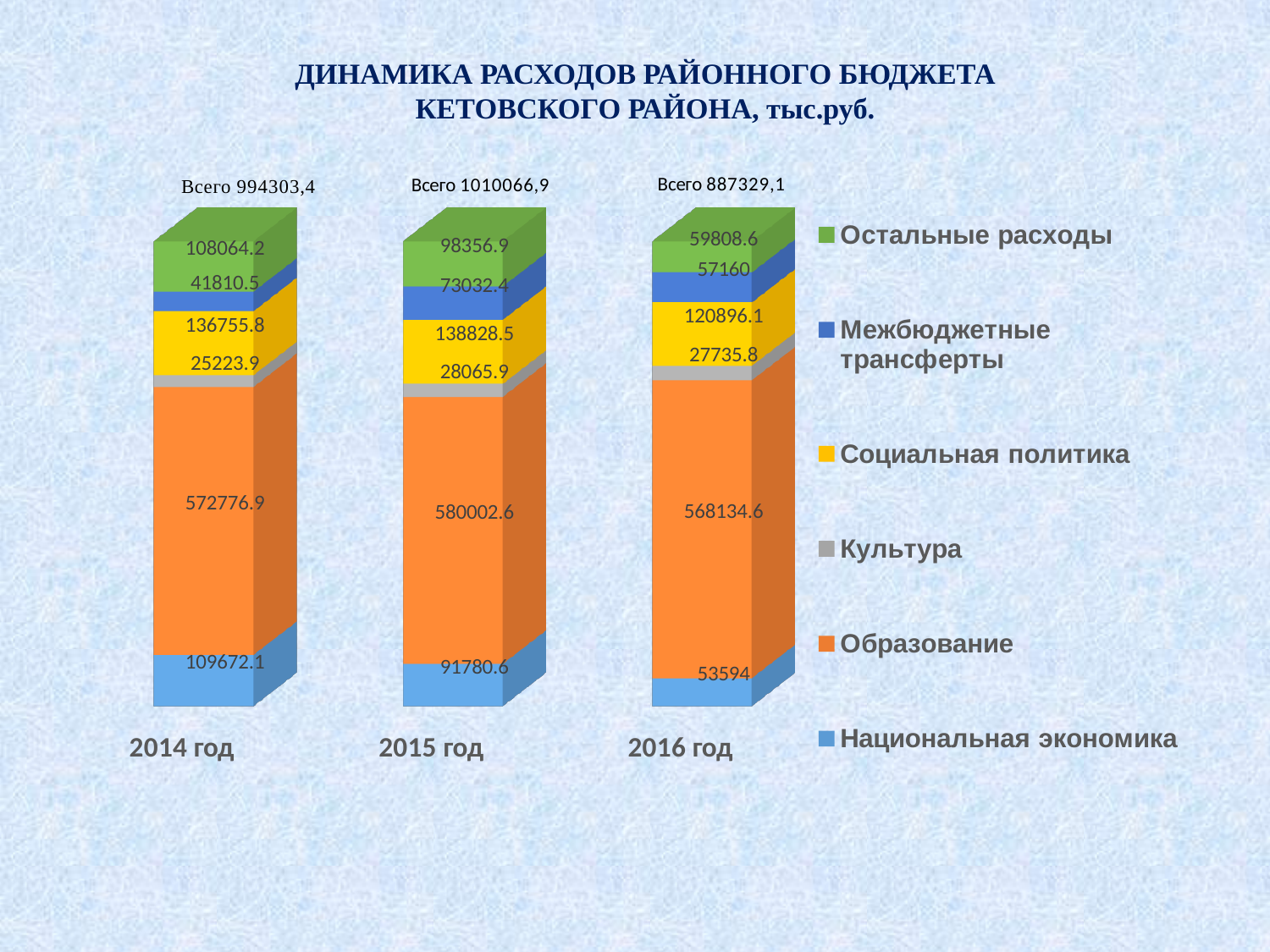
What is the difference between the Национальная экономика values for 2014 год and 2015 год? 17891.5 Which year has the lowest value for Национальная экономика? 2016 год How many series does the legend list? 6 What kind of chart is shown on the slide? Stacked bar chart How many years (bars) are shown in the chart? 3 Does the value for Остальные расходы rise or fall from 2014 год to 2016 год? Fall What is the total (Всего) shown for 2015 год? 1010066,9 Which is larger: Остальные расходы in 2014 год or in 2015 год? 2014 год What is the value for Образование in 2014 год? 572776.9 Which year has the highest value for Социальная политика? 2015 год What is the value for Культура in 2015 год? 28065.9 What is the value for Межбюджетные трансферты in 2016 год? 57160